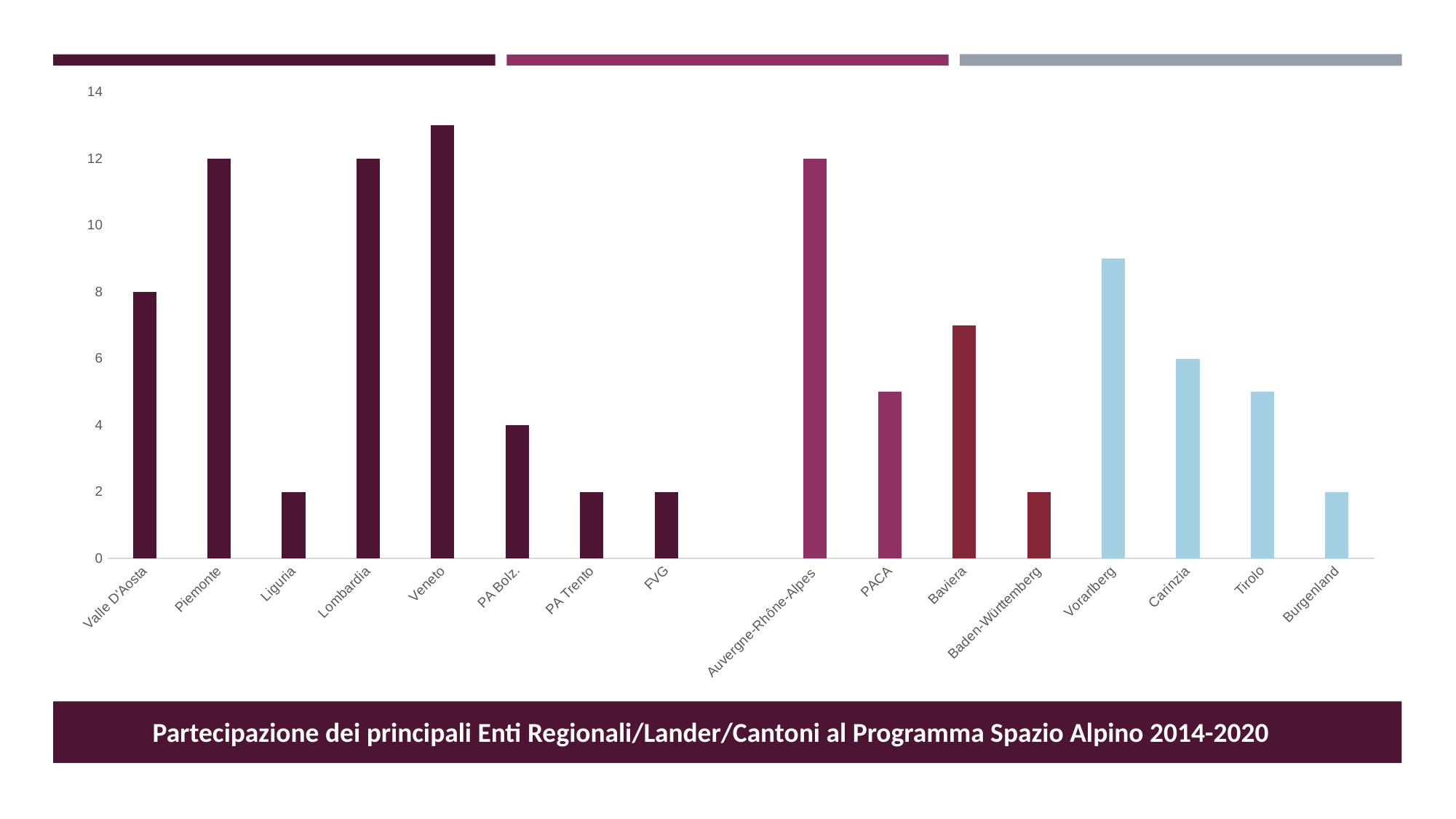
What is the value for Auvergne-Rhône-Alpes? 12 What type of chart is shown on the slide? Bar chart Is the value for Vorarlberg greater or less than 8? greater Which category has the highest bar? Veneto What is the value for Carinzia? 6 Which is larger, the value for Lombardia or the value for PA Bolz.? Lombardia What is the title shown below the chart? Partecipazione dei principali Enti Regionali/Lander/Cantoni al Programma Spazio Alpino 2014-2020 What is the value for PA Bolz.? 4 What is the value for Piemonte? 12 What is the difference between the values for Piemonte and Valle D'Aosta? 4 How many categories are plotted on the x axis? 16 What is the value for Valle D'Aosta? 8